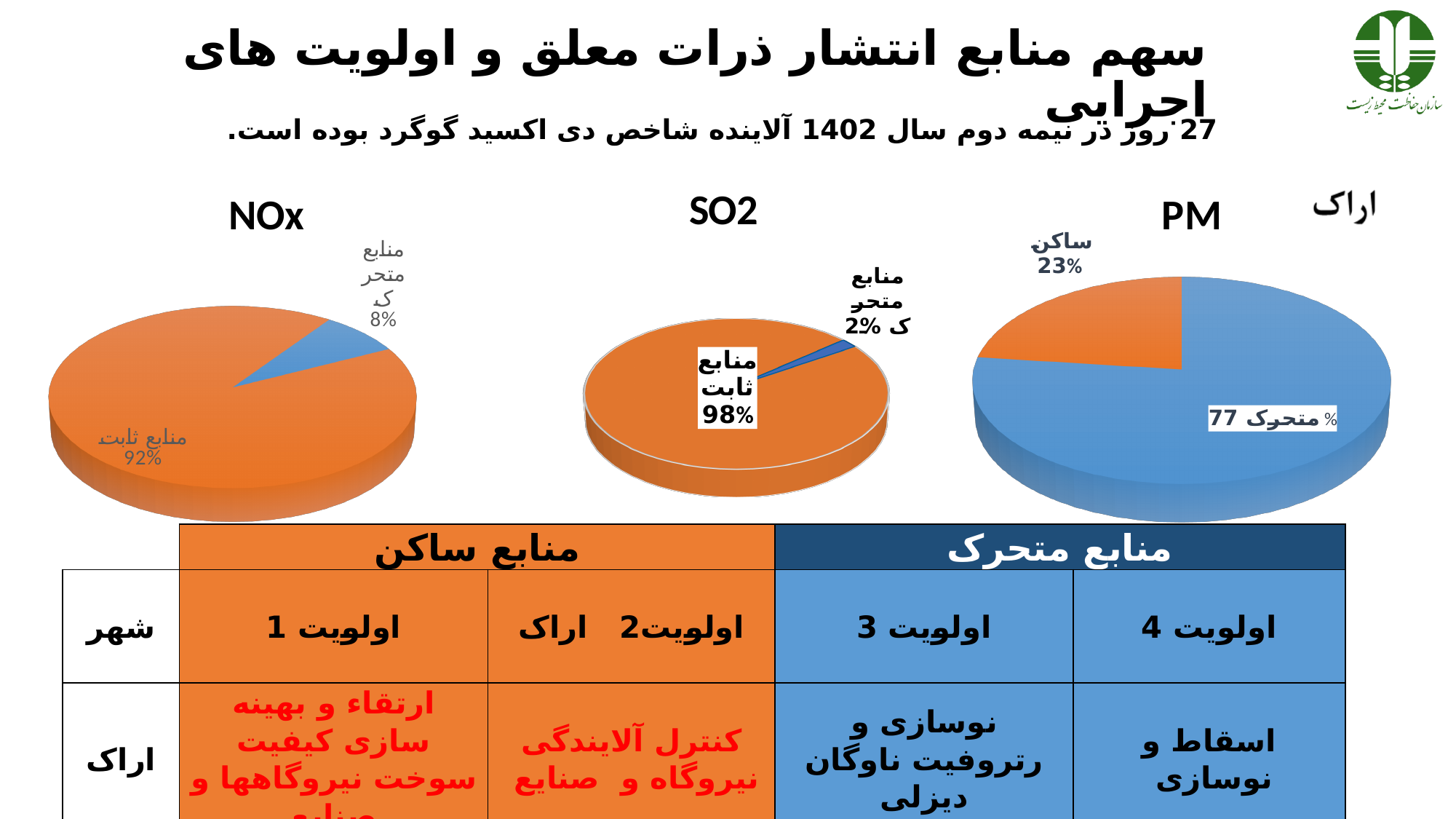
In the SO2 pie chart, which slice is the smallest? منابع متحرک In the PM pie chart, which is larger: ساکن or متحرک? متحرک In the PM pie chart, what share is labelled for متحرک? 77% How many slices does the NOx pie chart have? 2 In the PM pie chart, which slice is the largest? متحرک What kind of chart is the SO2 chart? Pie chart In the NOx pie chart, what share is labelled for منابع ثابت? 92% In the NOx pie chart, what share is labelled for منابع متحرک? 8% In the SO2 pie chart, what share is labelled for منابع متحرک? 2% In the SO2 pie chart, what share is labelled for منابع ثابت? 98% In the PM pie chart, what share is labelled for ساکن? 23% In the NOx pie chart, what is the difference in percentage points between منابع ثابت and منابع متحرک? 84